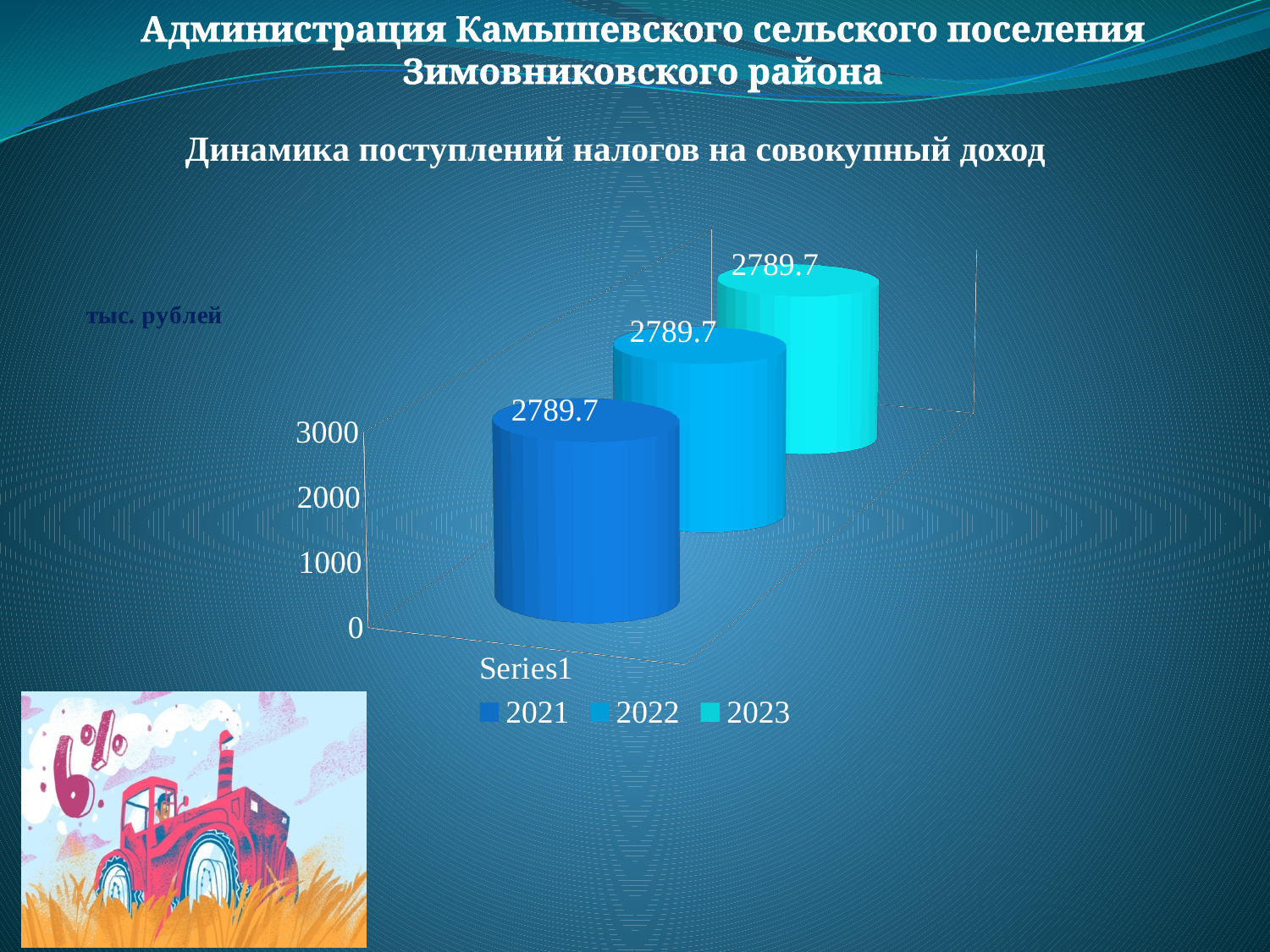
What unit is indicated for the chart values? тыс. рублей Do the values change from 2021 to 2023? No, they stay the same What is the title of the chart? Динамика поступлений налогов на совокупный доход What is the value for 2022 on the chart? 2789.7 What kind of chart is shown on the slide? bar chart Is the value for 2023 greater or less than 3000? less What is the difference between the values for 2023 and 2021? 0 What is the value for 2023 on the chart? 2789.7 Is the value for 2022 greater or less than 2000? greater How many series does the legend list? 3 What is the category label shown on the x axis? Series1 What is the value for 2021 on the chart? 2789.7